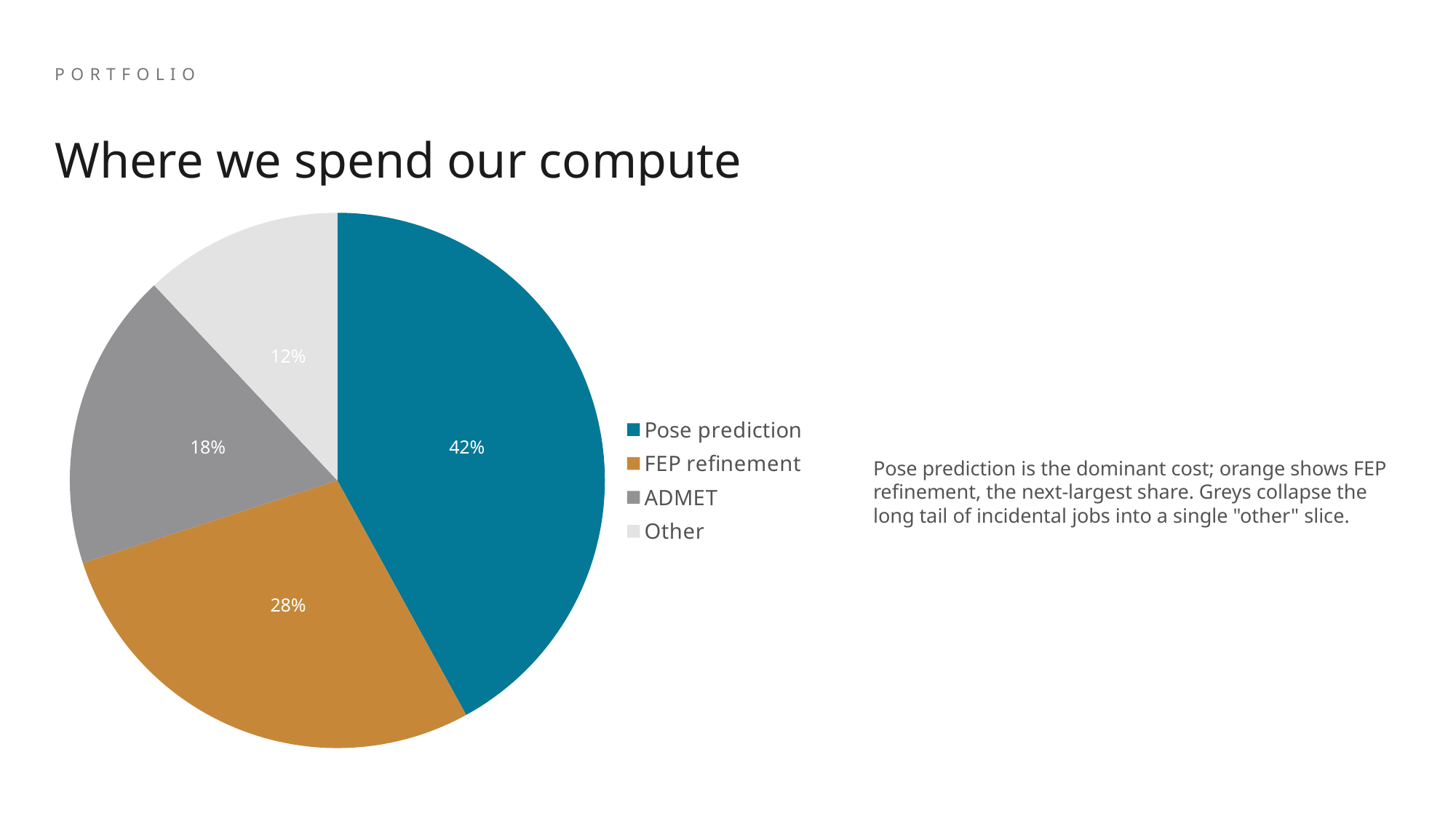
What share of compute does FEP refinement account for? 28% Which category has the largest slice of the pie? Pose prediction What share of compute does Pose prediction account for? 42% How many percentage points larger is ADMET than Other? 6 Which category has the smallest slice of the pie? Other What kind of chart is shown on the slide? Pie chart What share of compute does Other account for? 12% How many percentage points larger is Pose prediction than FEP refinement? 14 Which is larger, the FEP refinement slice or the ADMET slice? FEP refinement What share of compute does ADMET account for? 18% What is the title of the chart? Where we spend our compute How many categories does the pie chart show? 4